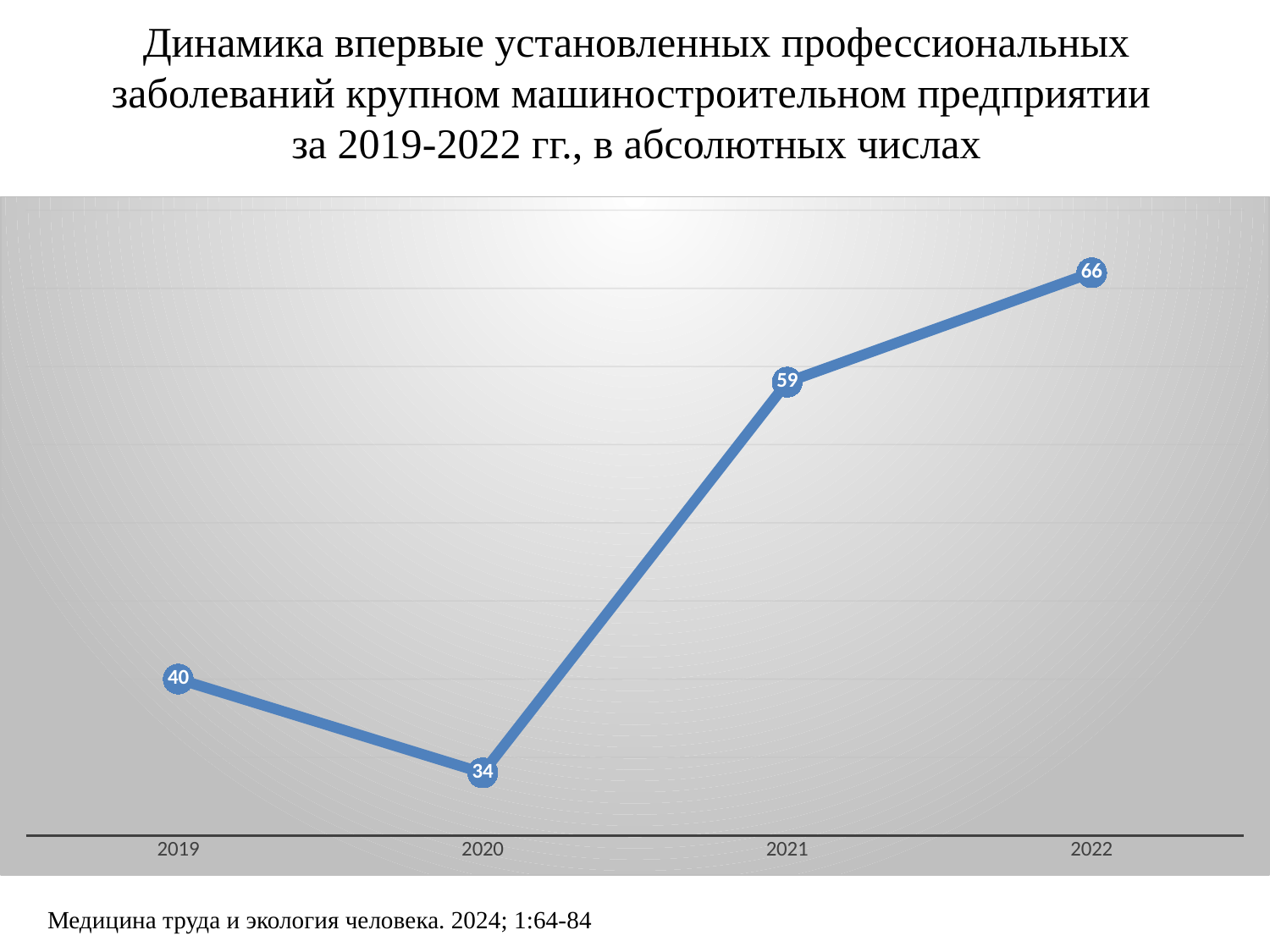
What is the value for 2019? 40 What is the value for 2021? 59 Which year has the lowest value? 2020 What kind of chart is shown on the slide? line chart How many years are plotted on the chart? 4 What is the difference between the values for 2021 and 2020? 25 Do the values rise or fall from 2020 to 2022? rise Which is larger, the value for 2019 or the value for 2020? 2019 What is the value for 2022? 66 What is the value for 2020? 34 What is the difference between the values for 2022 and 2019? 26 Which year has the highest value? 2022